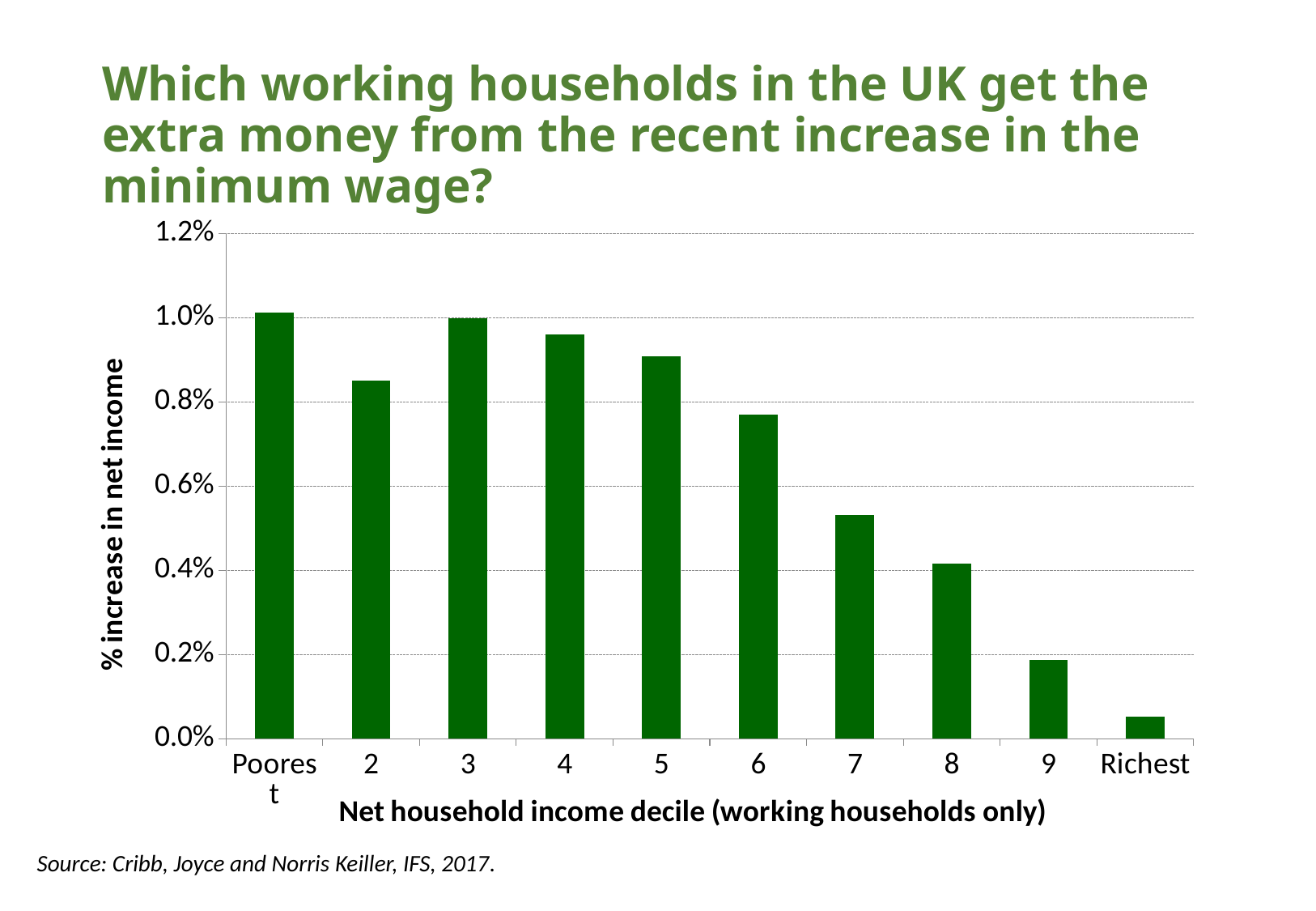
Which income decile has the lowest % increase in net income? Richest How many income decile categories are plotted on the x axis? 10 Is the value for decile 6 greater or less than 0.8%? less Overall, do the values rise or fall moving from the Poorest to the Richest decile? Fall What kind of chart is shown on the slide? Bar chart Is the value for decile 7 greater or less than 0.4%? greater Is the value for the Richest decile greater or less than 0.2%? less What is the title of the y axis? % increase in net income Which has the larger % increase in net income, decile 2 or decile 6? Decile 2 Which has the larger % increase in net income, decile 9 or the Richest decile? Decile 9